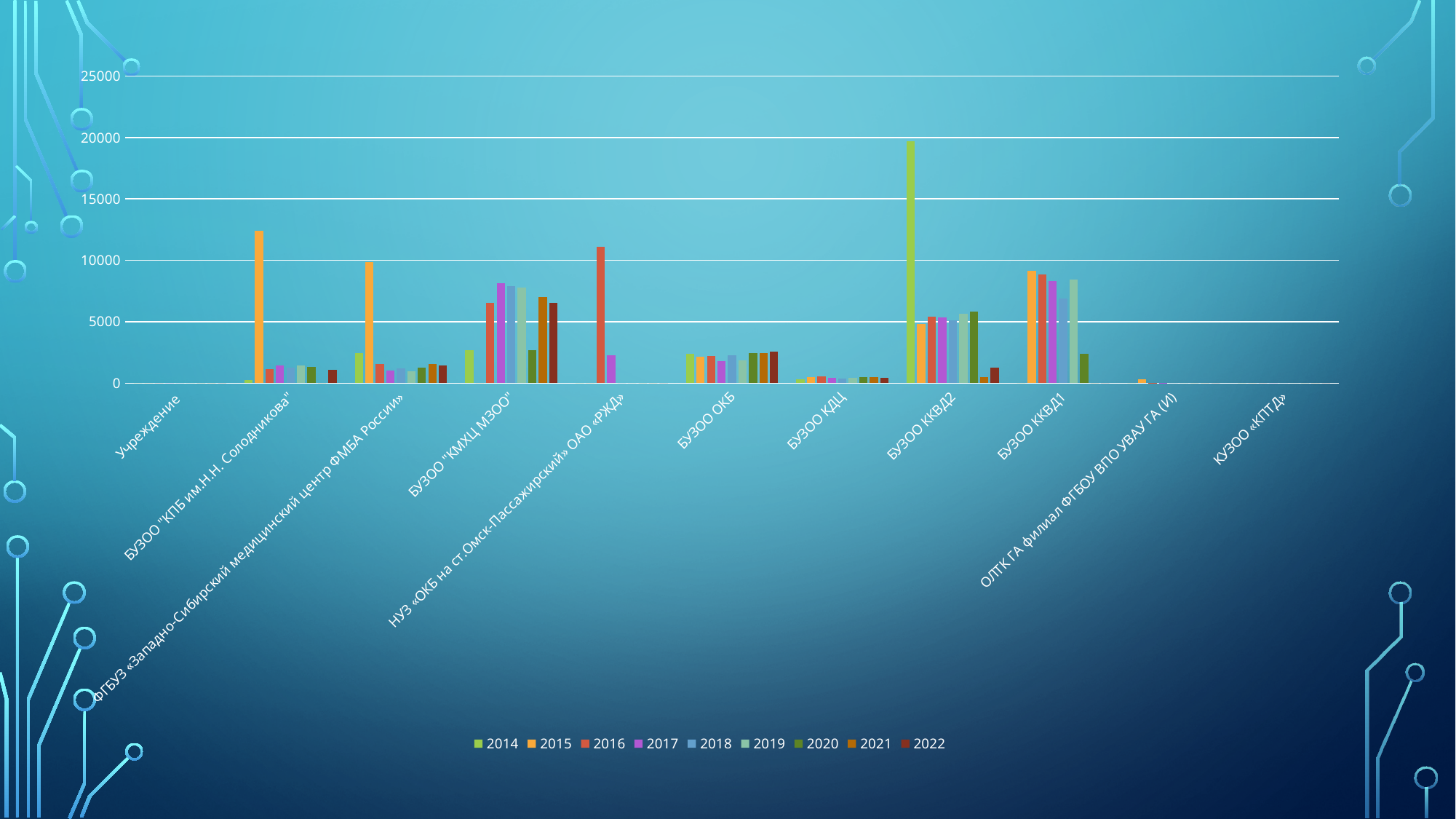
Is the 2014 value for БУЗОО "КМХЦ МЗОО" greater or less than 5000? less Which year has the highest value for НУЗ «ОКБ на ст.Омск-Пассажирский» ОАО «РЖД»? 2016 Is the 2016 value for НУЗ «ОКБ на ст.Омск-Пассажирский» ОАО «РЖД» greater or less than 10000? greater Is the 2014 value for БУЗОО ККВД2 greater or less than 15000? greater Which year has the highest value for БУЗОО ККВД2? 2014 Which category has the tallest bar in the chart? БУЗОО ККВД2 What kind of chart is shown on the slide? bar chart How many series does the legend list? 9 Which is larger: the 2015 value for БУЗОО "КПБ им.Н.Н. Солодникова" or the 2015 value for ФГБУЗ «Западно-Сибирский медицинский центр ФМБА России»? БУЗОО "КПБ им.Н.Н. Солодникова" How many categories are shown along the x axis? 11